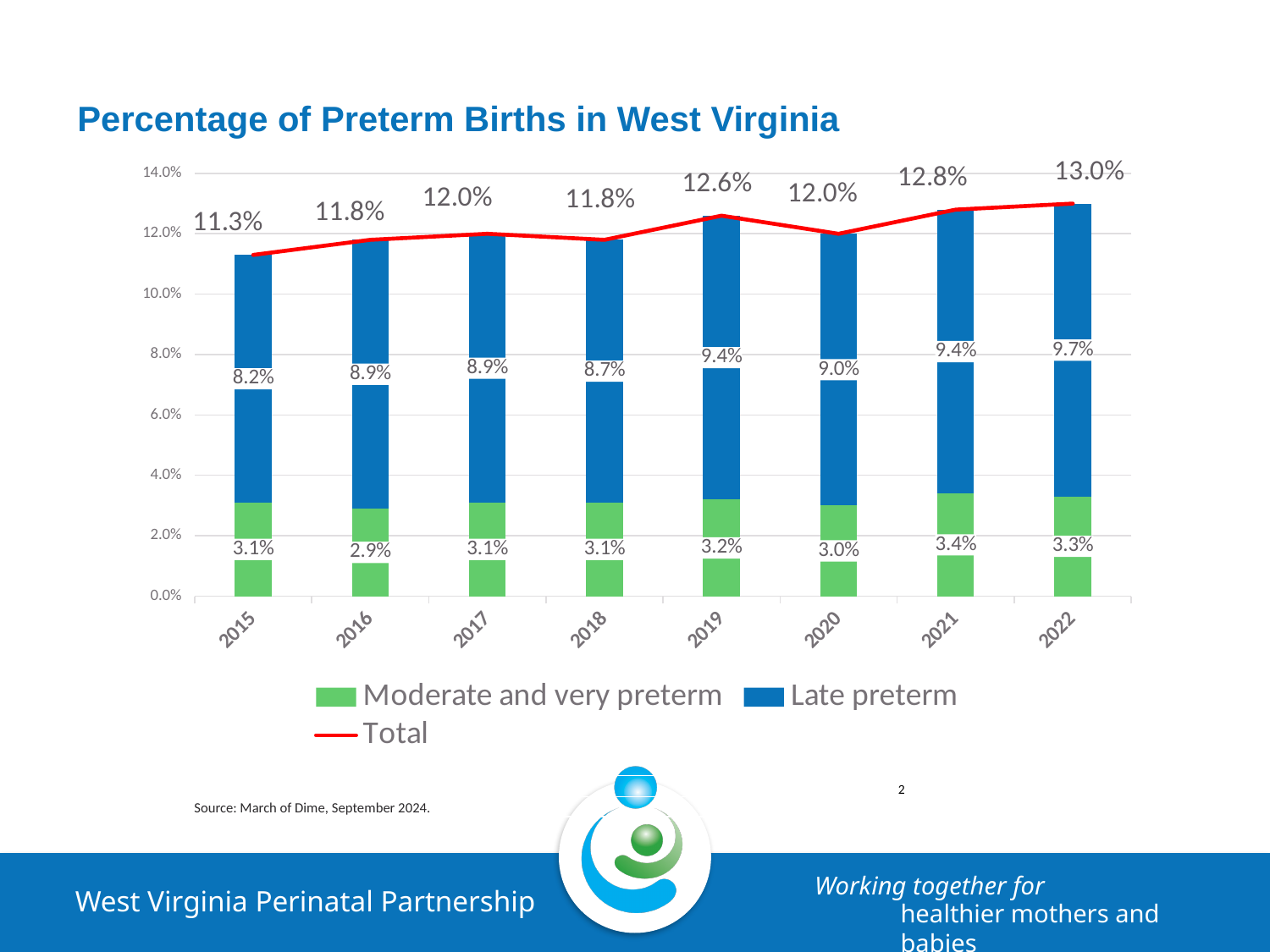
What is the difference between the Late preterm values for 2022 and 2015? 1.5% Which year has the highest Total value? 2022 How many years are shown on the x axis? 8 Which is larger, the Late preterm value for 2018 or for 2020? 2020 What is the total of the stacked bar for 2017? 12.0% What is the Moderate and very preterm value for 2021? 3.4% Which year has the lowest Moderate and very preterm value? 2016 What kind of chart is this? Stacked bar chart with a line How many series does the legend list? 3 What is the Total value for 2015? 11.3% What is the Late preterm value for 2019? 9.4% Does the Total value rise or fall from 2015 to 2022 overall? Rise